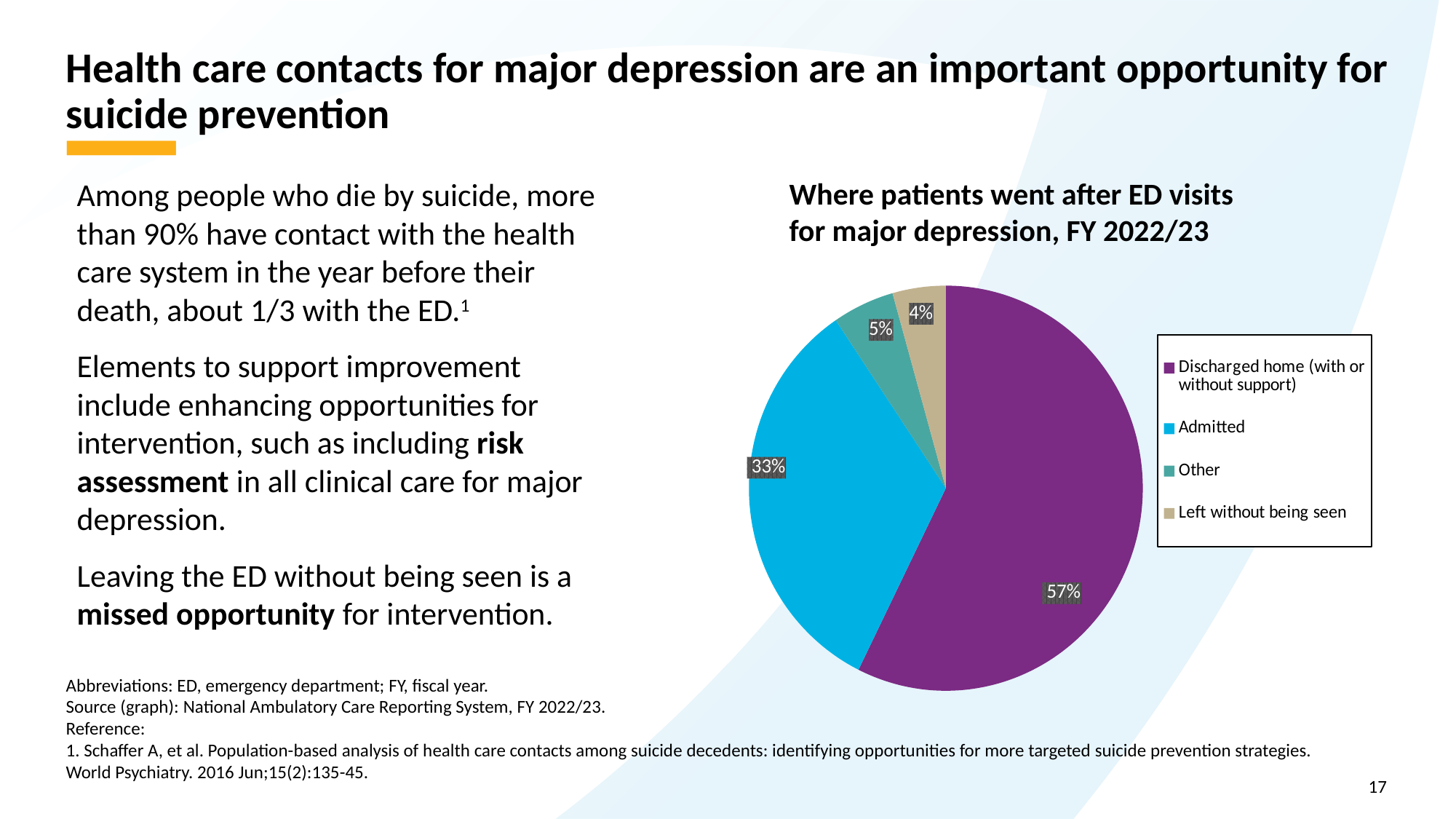
What is the difference in percentage points between the 'Discharged home' and 'Admitted' shares? 24 percentage points Which category has the largest share of the pie? Discharged home (with or without support) What share of patients fall under 'Other'? 5% What is the title of the chart? Where patients went after ED visits for major depression, FY 2022/23 How many categories does the legend list? 4 What share of patients were admitted? 33% What share of patients were discharged home (with or without support)? 57% Which category has the smallest share of the pie? Left without being seen Which is larger, the share for 'Other' or the share for 'Left without being seen'? Other What colour represents the 'Admitted' category in the pie chart? Blue What kind of chart is shown on the slide? Pie chart